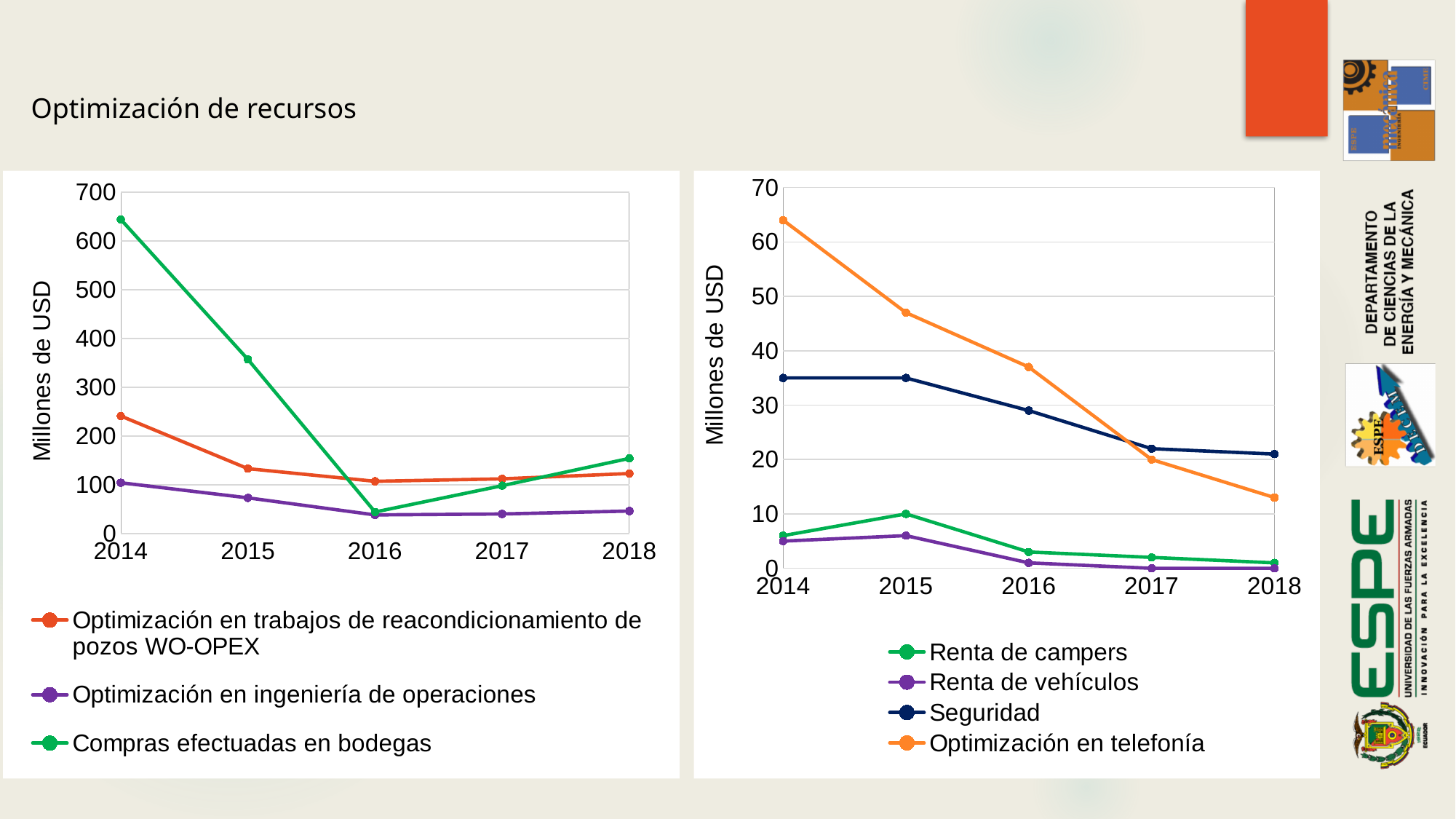
What is the y-axis label of the right chart? Millones de USD In the left chart, is the value for Compras efectuadas en bodegas in 2016 greater or less than 100? less In the right chart, is the value for Optimización en telefonía in 2014 greater or less than 60? greater In the right chart, which series has the highest value in 2018? Seguridad How many years are shown on the x axis of the right chart? 5 How many series does the legend of the left chart list? 3 In the left chart, which series has the highest value in 2014? Compras efectuadas en bodegas What kind of chart is the left chart on the slide? line chart In the left chart, which is larger in 2015: Compras efectuadas en bodegas or Optimización en trabajos de reacondicionamiento de pozos WO-OPEX? Compras efectuadas en bodegas How many series does the legend of the right chart list? 4 In the right chart, does the value for Optimización en telefonía rise or fall from 2014 to 2018? fall In the left chart, is the value for Compras efectuadas en bodegas in 2014 greater or less than 600? greater